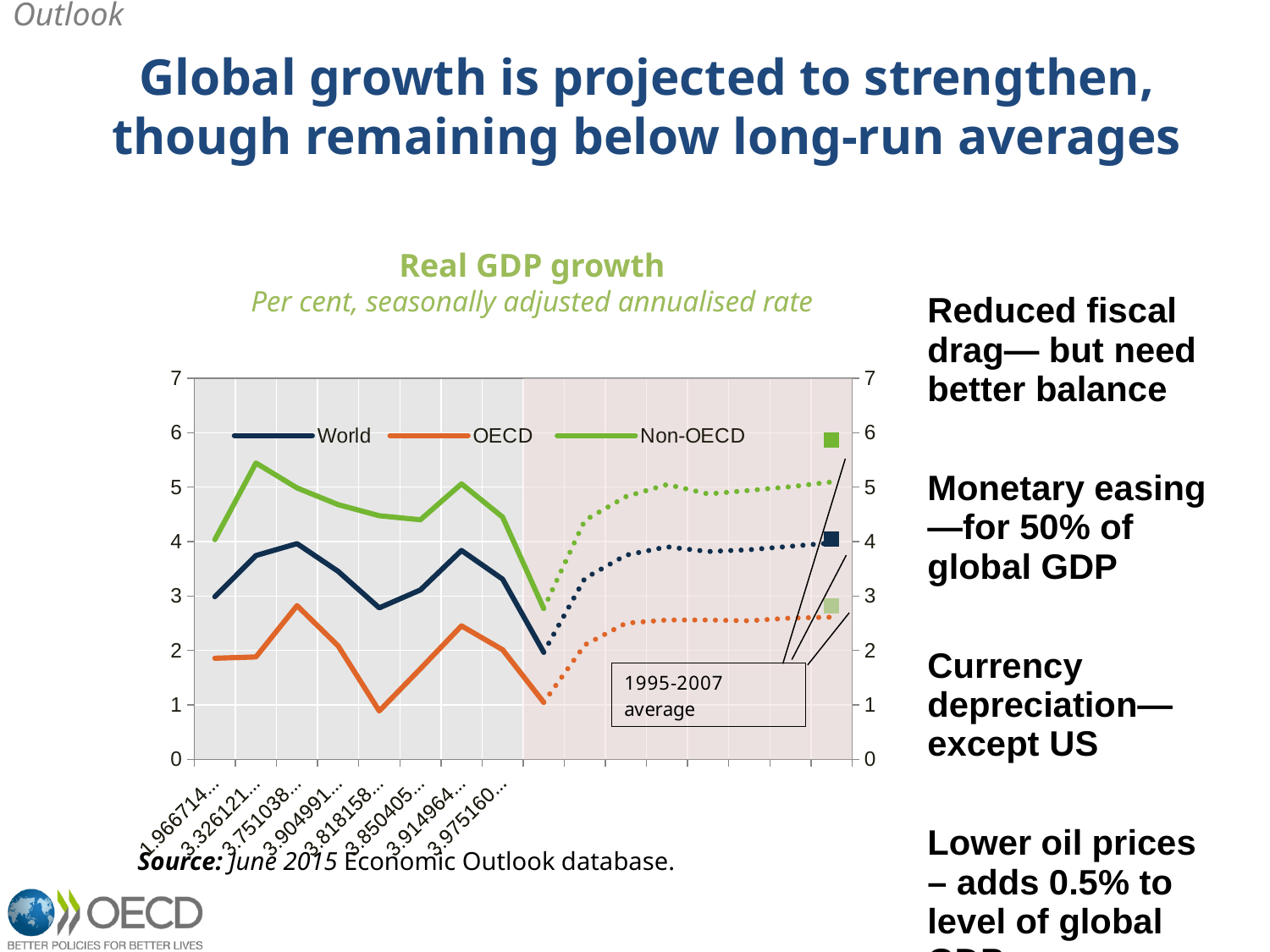
Which is larger at the first point on the chart, the World value or the OECD value? World How many series does the legend of the Real GDP growth chart list? 3 Is the 1995-2007 average marker for OECD greater or less than 3? less What kind of chart is shown on the slide? Line chart Which series are listed in the chart's legend? World, OECD, Non-OECD Which series has the lowest values throughout the chart? OECD Does the Non-OECD line rise or fall between its first and second points? rise Is the highest point of the OECD solid line greater or less than 3? less Is the highest point of the Non-OECD line greater or less than 5? greater What is the title of the chart? Real GDP growth Which series has the highest values throughout the chart? Non-OECD What is the maximum value shown on the chart's vertical axis? 7